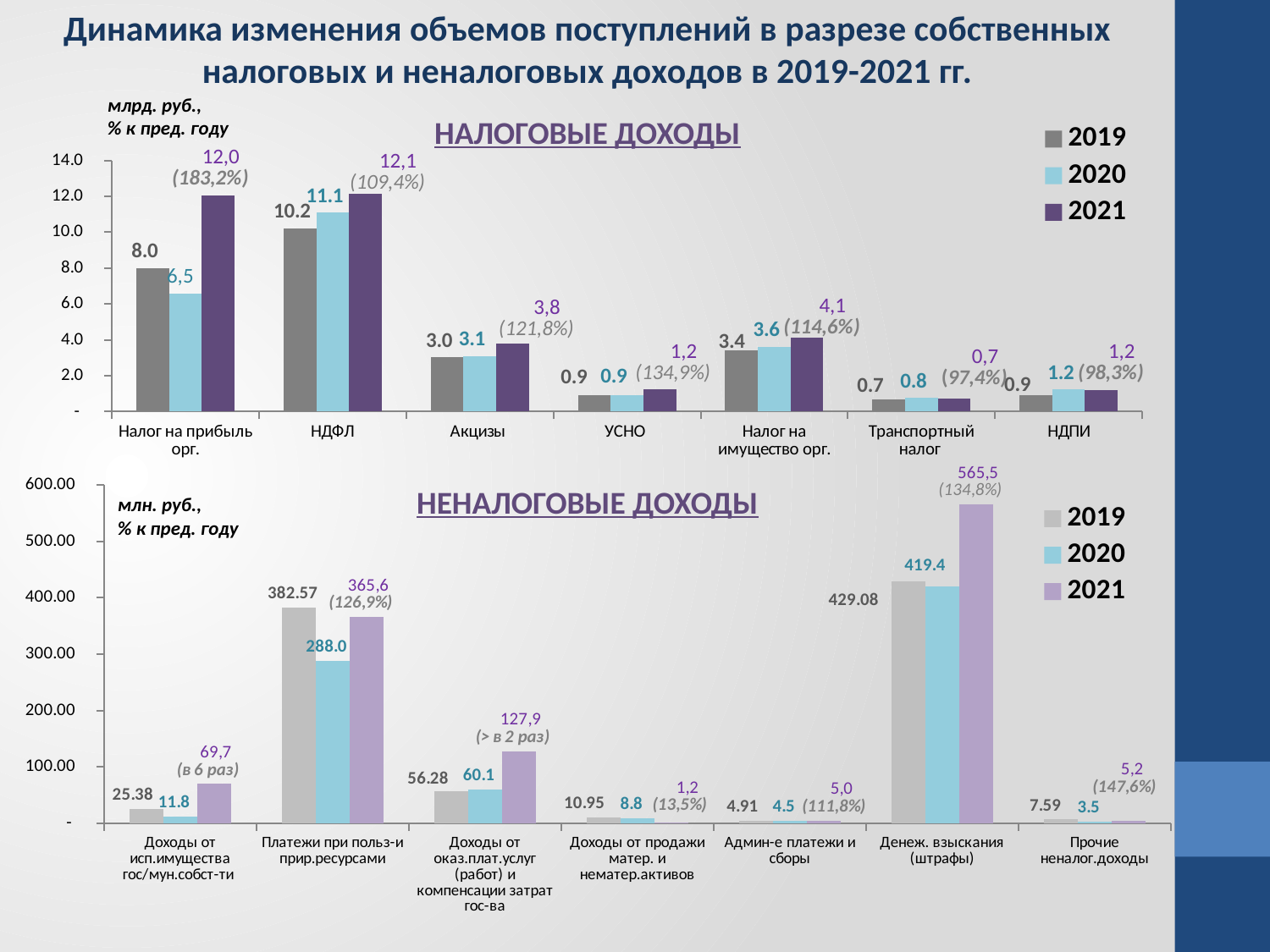
In the НЕНАЛОГОВЫЕ ДОХОДЫ chart, which is larger for Платежи при польз-и прир.ресурсами: the 2019 value or the 2021 value? 2019 In the НЕНАЛОГОВЫЕ ДОХОДЫ chart, how many series does the legend list? 3 In the НАЛОГОВЫЕ ДОХОДЫ chart, what is the difference between the 2021 and 2020 values for Налог на прибыль орг.? 5,5 What kind of chart is the НЕНАЛОГОВЫЕ ДОХОДЫ chart? Bar chart In the НАЛОГОВЫЕ ДОХОДЫ chart, what percentage to the previous year is shown for Акцизы in 2021? 121,8% In the НАЛОГОВЫЕ ДОХОДЫ chart, which category has the highest 2021 value? НДФЛ In the НЕНАЛОГОВЫЕ ДОХОДЫ chart, what is the 2020 value for Доходы от оказ.плат.услуг (работ) и компенсации затрат гос-ва? 60.1 In the НЕНАЛОГОВЫЕ ДОХОДЫ chart, what is the 2021 value for Денеж. взыскания (штрафы)? 565,5 In the НЕНАЛОГОВЫЕ ДОХОДЫ chart, which category has the lowest 2021 value? Доходы от продажи матер. и нематер.активов In the НАЛОГОВЫЕ ДОХОДЫ chart, how many categories are shown on the x axis? 7 In the НАЛОГОВЫЕ ДОХОДЫ chart, what is the 2019 value for НДФЛ? 10.2 In the НАЛОГОВЫЕ ДОХОДЫ chart, what is the 2021 value for Налог на прибыль орг.? 12,0